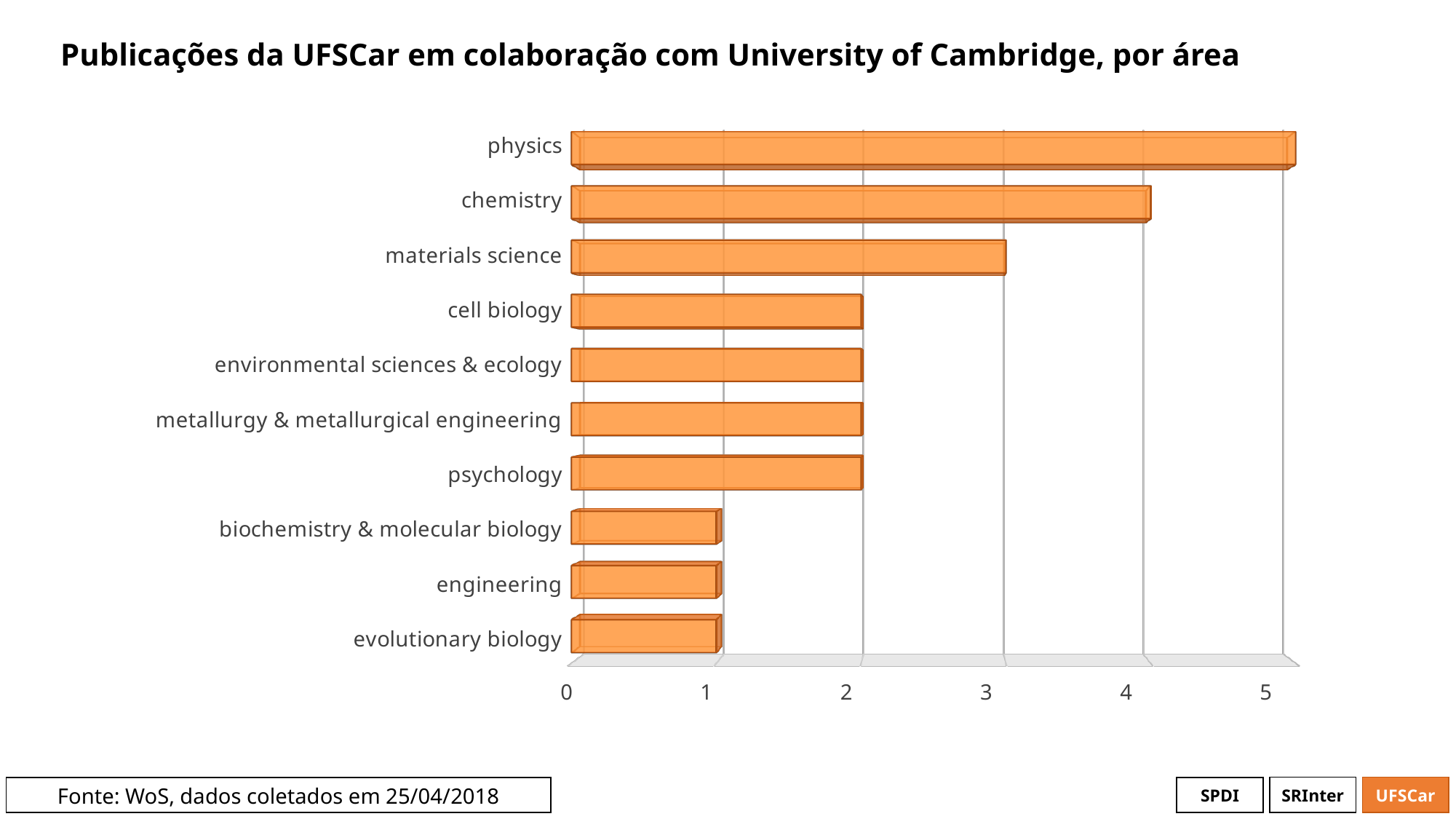
What kind of chart is shown on the slide? bar chart What is the value for chemistry? 4 What is the title of the chart? Publicações da UFSCar em colaboração com University of Cambridge, por área Which area has the highest number of publications? physics What is the value for physics? 5 What is the value for engineering? 1 Which is larger, the value for chemistry or the value for cell biology? chemistry How many areas are listed on the chart? 10 What is the difference between the values for physics and chemistry? 1 What is the value for psychology? 2 Is the value for materials science greater or less than 4? less What is the value for materials science? 3